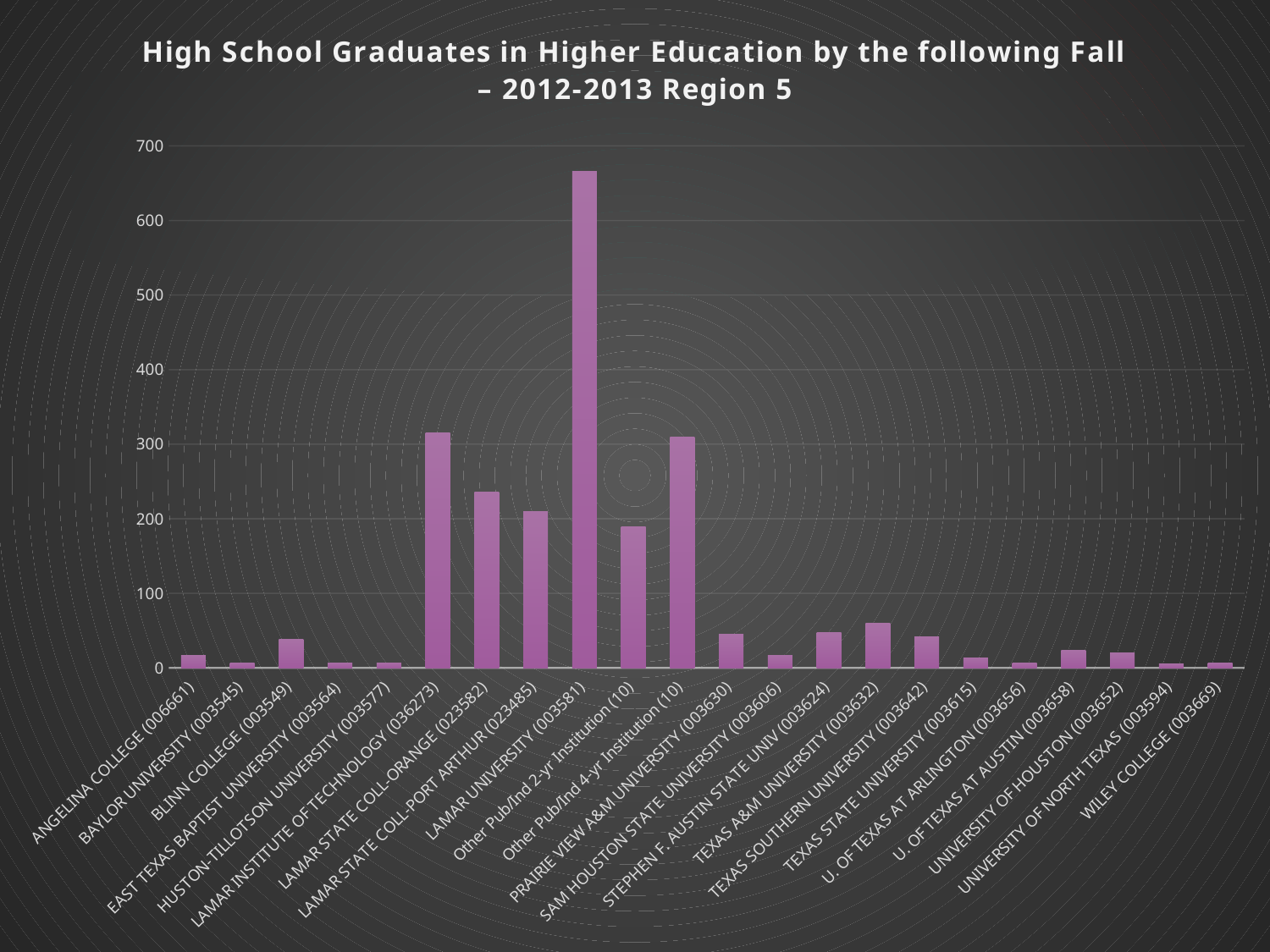
Which is larger: the value for Other Pub/Ind 4-yr Institution (10) or Other Pub/Ind 2-yr Institution (10)? Other Pub/Ind 4-yr Institution (10) Is the value for Other Pub/Ind 2-yr Institution (10) greater or less than 100? greater Is the value for LAMAR INSTITUTE OF TECHNOLOGY (036273) greater or less than 200? greater What is the title of the chart? High School Graduates in Higher Education by the following Fall – 2012-2013 Region 5 Which institution has the highest number of high school graduates in higher education? LAMAR UNIVERSITY (003581) Is the value for LAMAR STATE COLL-ORANGE (023582) greater or less than 300? less What kind of chart is shown on the slide? Bar chart Which is larger: the value for BLINN COLLEGE (003549) or BAYLOR UNIVERSITY (003545)? BLINN COLLEGE (003549) Which is larger: the value for LAMAR INSTITUTE OF TECHNOLOGY (036273) or LAMAR STATE COLL-ORANGE (023582)? LAMAR INSTITUTE OF TECHNOLOGY (036273) How many institutions/categories are shown on the x axis? 22